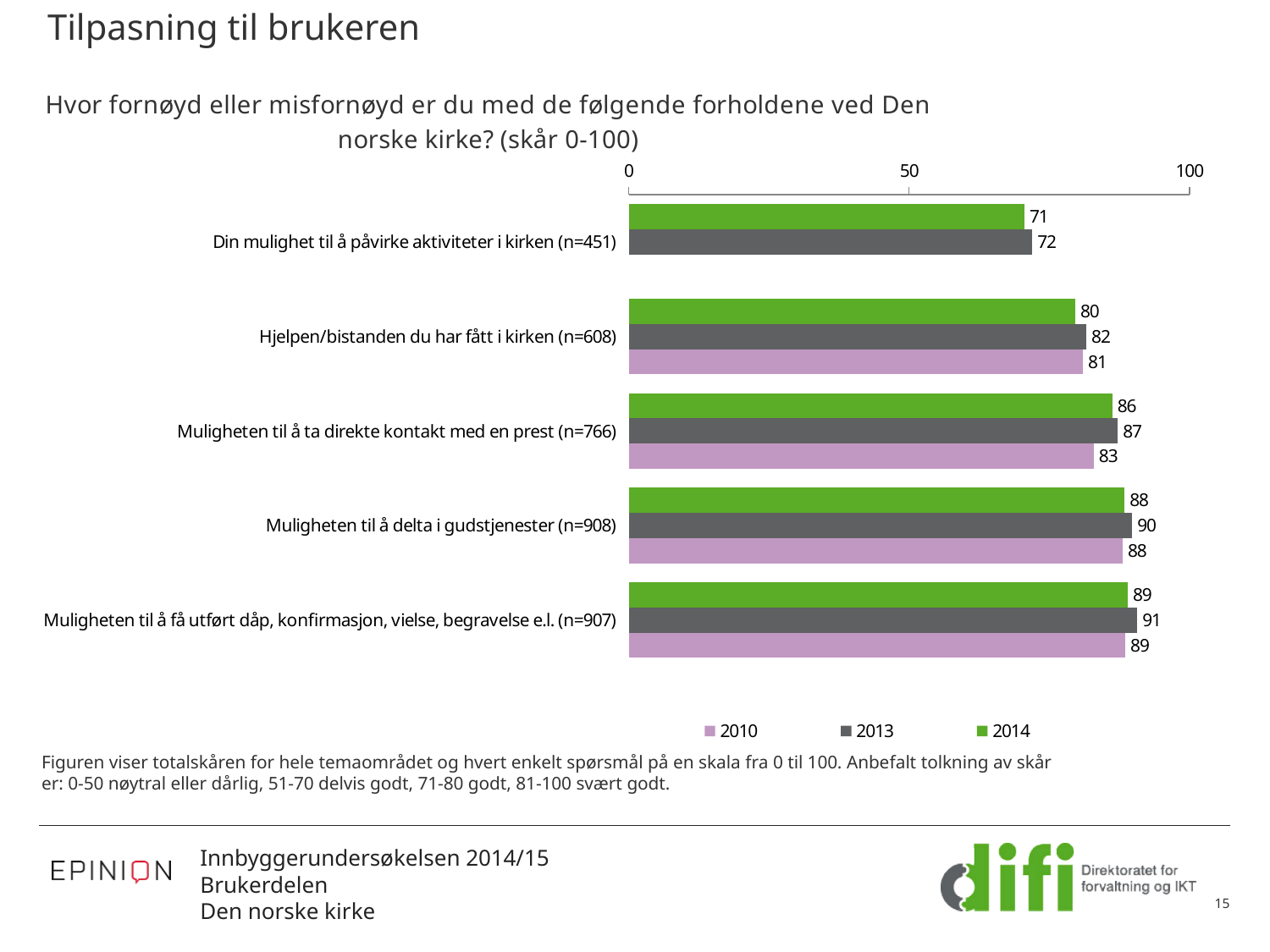
Which category has the highest 2013 value? Muligheten til å få utført dåp, konfirmasjon, vielse, begravelse e.l. (n=907) How many categories are shown on the chart? 5 Is the 2014 value for "Hjelpen/bistanden du har fått i kirken (n=608)" greater or less than 50? greater What is the 2010 value for "Muligheten til å ta direkte kontakt med en prest (n=766)"? 83 What is the difference between the 2013 and 2010 values for "Muligheten til å ta direkte kontakt med en prest (n=766)"? 4 What is the 2013 value for "Hjelpen/bistanden du har fått i kirken (n=608)"? 82 Which colour represents the 2014 series in the legend? green What kind of chart is shown on the slide? bar chart Which category has the lowest 2014 value? Din mulighet til å påvirke aktiviteter i kirken (n=451) How many series does the legend list? 3 For "Muligheten til å delta i gudstjenester (n=908)", which is larger: the 2013 value or the 2014 value? 2013 What is the 2014 value for "Din mulighet til å påvirke aktiviteter i kirken (n=451)"? 71